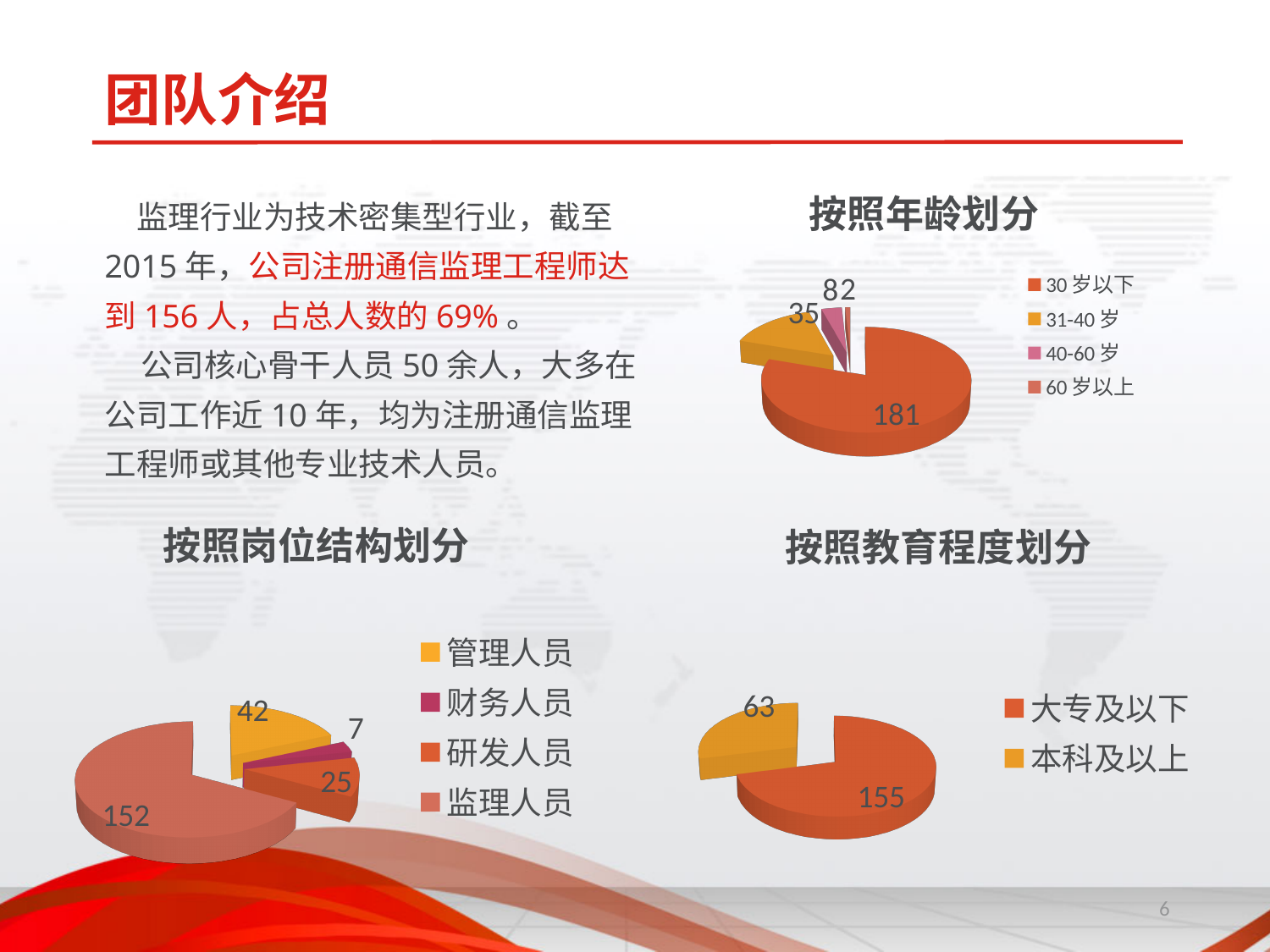
In the 按照岗位结构划分 chart, which is larger, 管理人员 or 研发人员? 管理人员 In the 按照年龄划分 chart, which age group has the largest slice? 30 岁以下 In the 按照教育程度划分 chart, what is the value for 本科及以上? 63 In the 按照年龄划分 chart, which age group has the smallest slice? 60 岁以上 In the 按照年龄划分 chart, what is the value for 30 岁以下? 181 In the 按照年龄划分 chart, how many categories does the legend list? 4 In the 按照年龄划分 chart, what is the value for 31-40 岁? 35 In the 按照教育程度划分 chart, what is the difference between 大专及以下 and 本科及以上? 92 In the 按照岗位结构划分 chart, what is the value for 财务人员? 7 What type of chart is the 按照教育程度划分 chart? Pie chart In the 按照岗位结构划分 chart, what is the difference between 管理人员 and 研发人员? 17 In the 按照岗位结构划分 chart, what is the value for 监理人员? 152